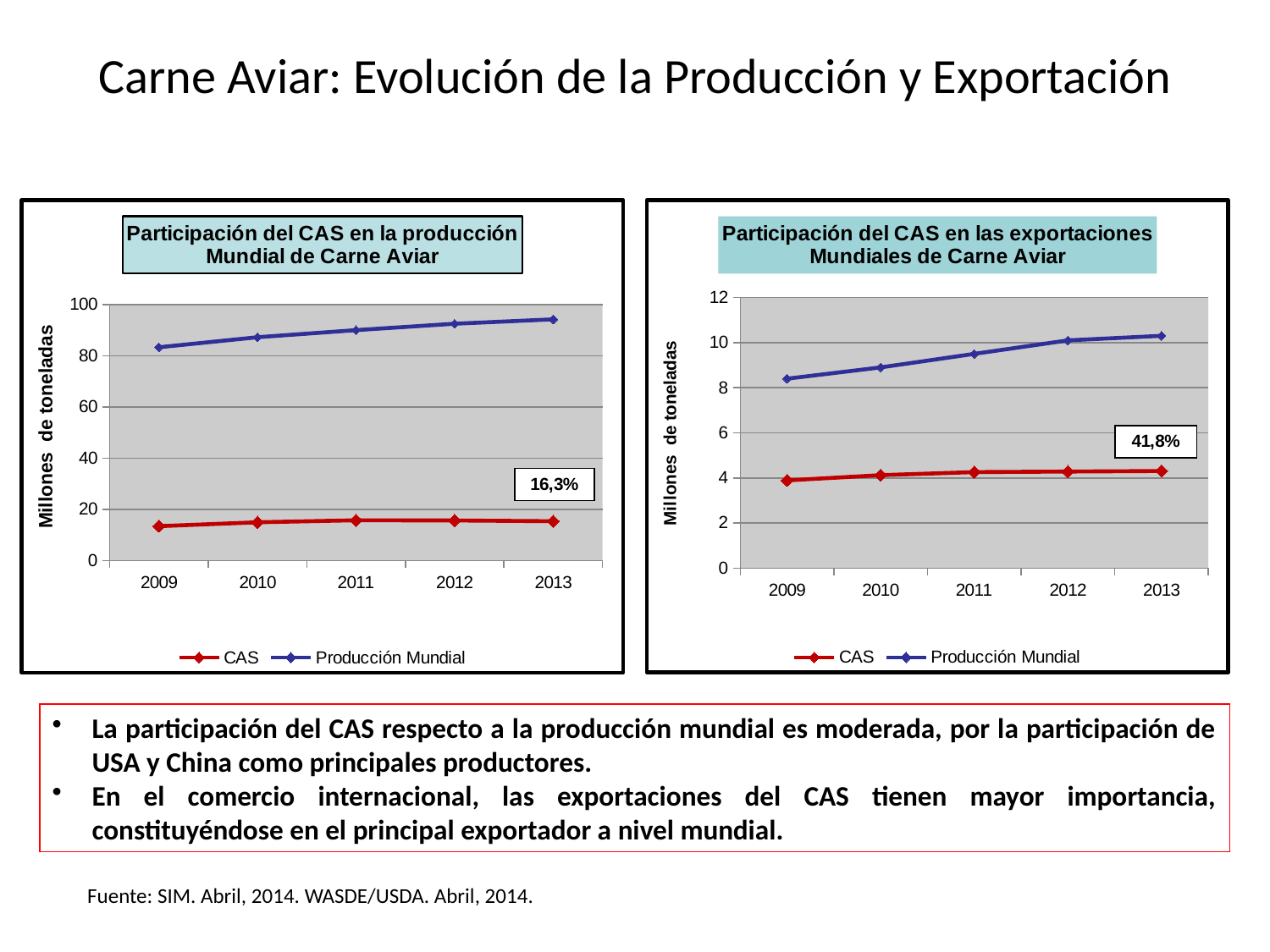
In the right chart (exportaciones Mundiales), is the CAS value for 2009 greater or less than 6? less In the left chart (producción Mundial), does the Producción Mundial line rise or fall from 2009 to 2013? Rise What percentage is shown in the annotation box on the right chart (exportaciones Mundiales)? 41,8% In the right chart (exportaciones Mundiales), which series has the higher value in 2013, CAS or Producción Mundial? Producción Mundial In the right chart (exportaciones Mundiales), is the Producción Mundial value for 2011 greater or less than 10? less What percentage is shown in the annotation box on the left chart (producción Mundial)? 16,3% In the right chart (exportaciones Mundiales), does the Producción Mundial line rise or fall from 2009 to 2013? Rise What kind of chart is the left chart, 'Participación del CAS en la producción Mundial de Carne Aviar'? Line chart In the left chart (producción Mundial), how many years are plotted on the x axis? 5 In the left chart (producción Mundial), is the Producción Mundial value for 2009 greater or less than 80? greater In the left chart (producción Mundial), how many series does the legend list? 2